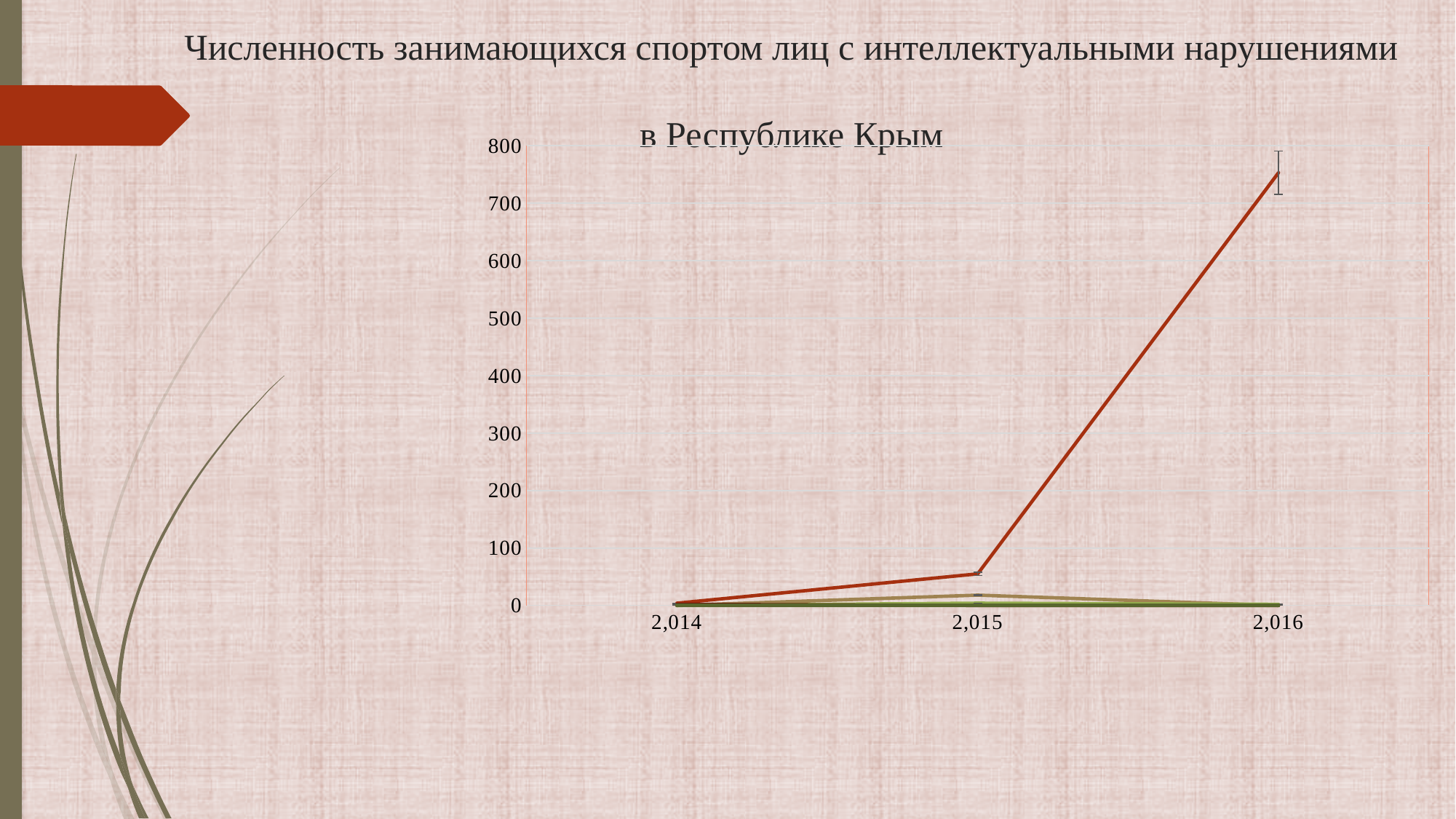
Which is larger for the red line: the value for 2,015 or the value for 2,016? 2,016 In which year does the red line reach its highest value? 2,016 Is the value of the red line for 2,016 greater or less than 700? greater How many years are shown on the x axis of the chart? 3 Does the red line rise or fall from 2,014 to 2,016? rise Is the value of the red line for 2,015 greater or less than 100? less What is the first year shown on the x axis of the chart? 2,014 What is the highest value shown on the y axis of the chart? 800 What kind of chart is shown on the slide? line chart Is the value of the red line for 2,014 greater or less than 100? less